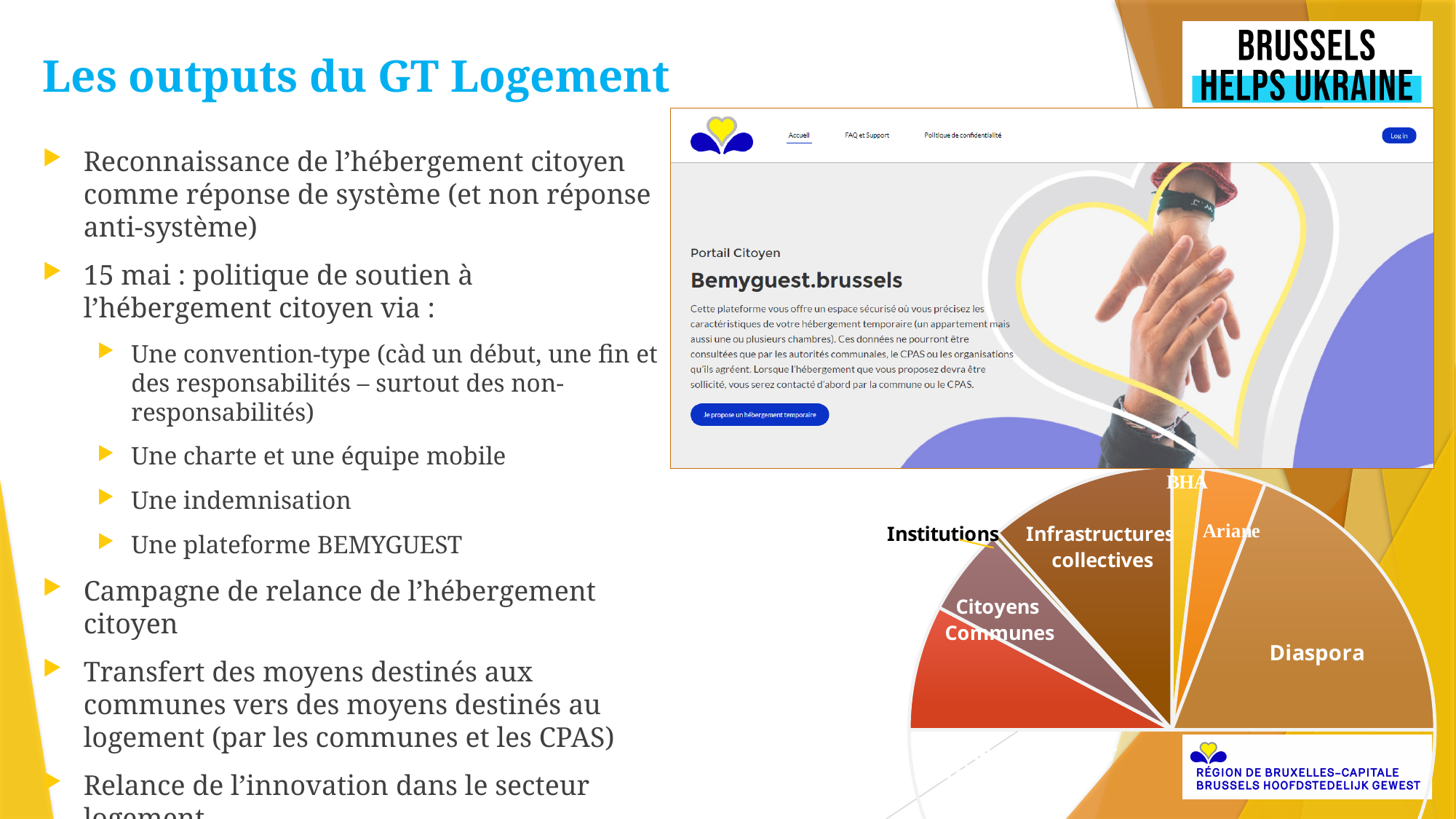
In the pie chart, which slice is larger, Infrastructures collectives or BHA? Infrastructures collectives What colour is the Diaspora slice in the pie chart? brown What kind of chart is shown at the bottom right of the slide? pie chart In the pie chart, which slice is larger, Diaspora or Institutions? Diaspora How many labelled slices are visible in the pie chart? 6 Which slice of the pie chart is labelled with a leader line pointing to a very thin slice? Institutions In the pie chart, which slice is larger, Diaspora or Ariane? Diaspora